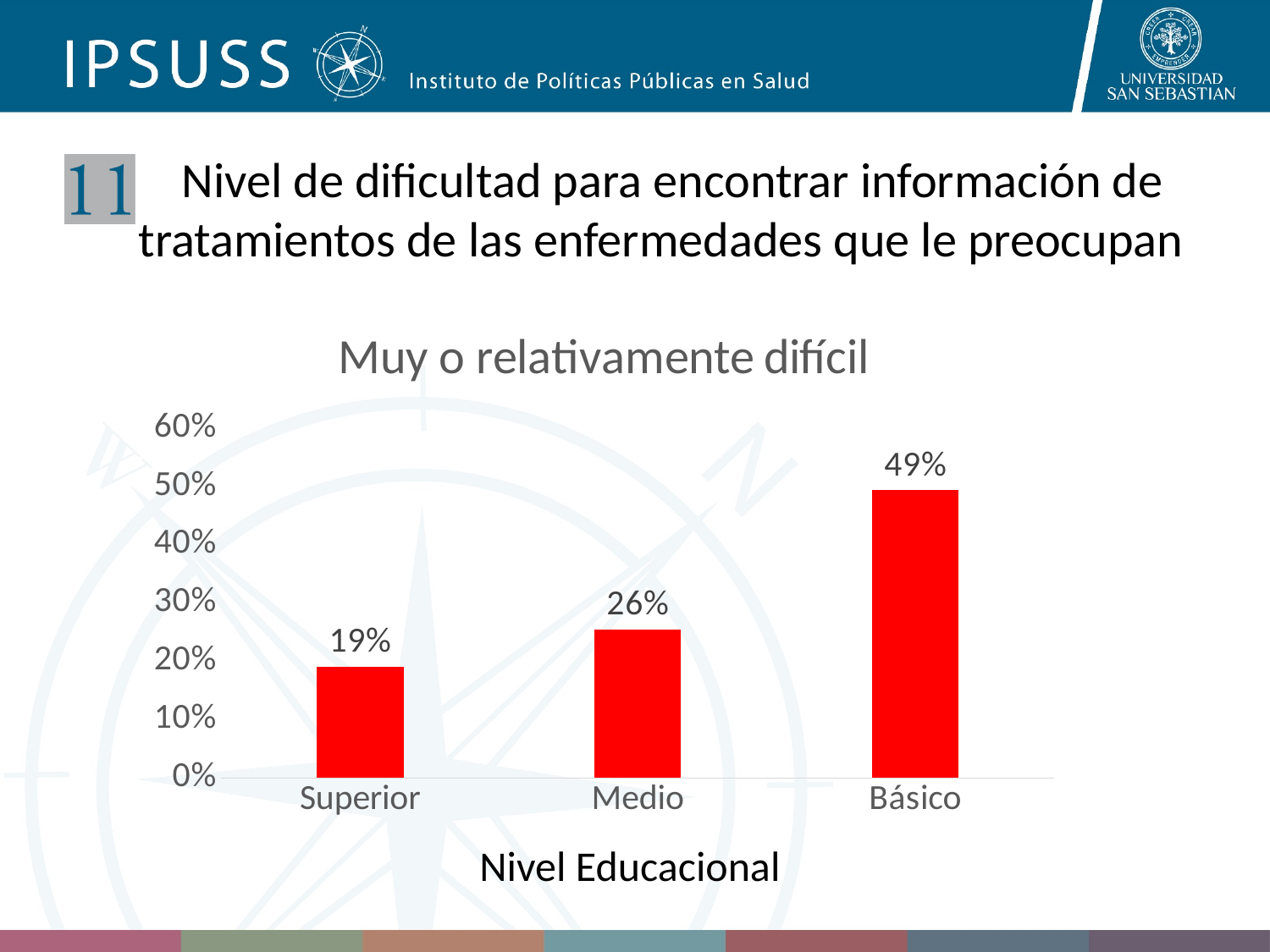
What is the difference between the values for Básico and Superior? 30% Which educational level has the lowest value? Superior What kind of chart is shown? bar chart What is the value for Básico? 49% What is the value for Superior? 19% Is the value for Básico greater or less than 40%? greater What is the value for Medio? 26% How many categories are shown on the x axis? 3 Which educational level has the highest value? Básico Which is larger, the value for Medio or the value for Básico? Básico What is the title of the chart? Muy o relativamente difícil What is the difference between the values for Medio and Superior? 7%